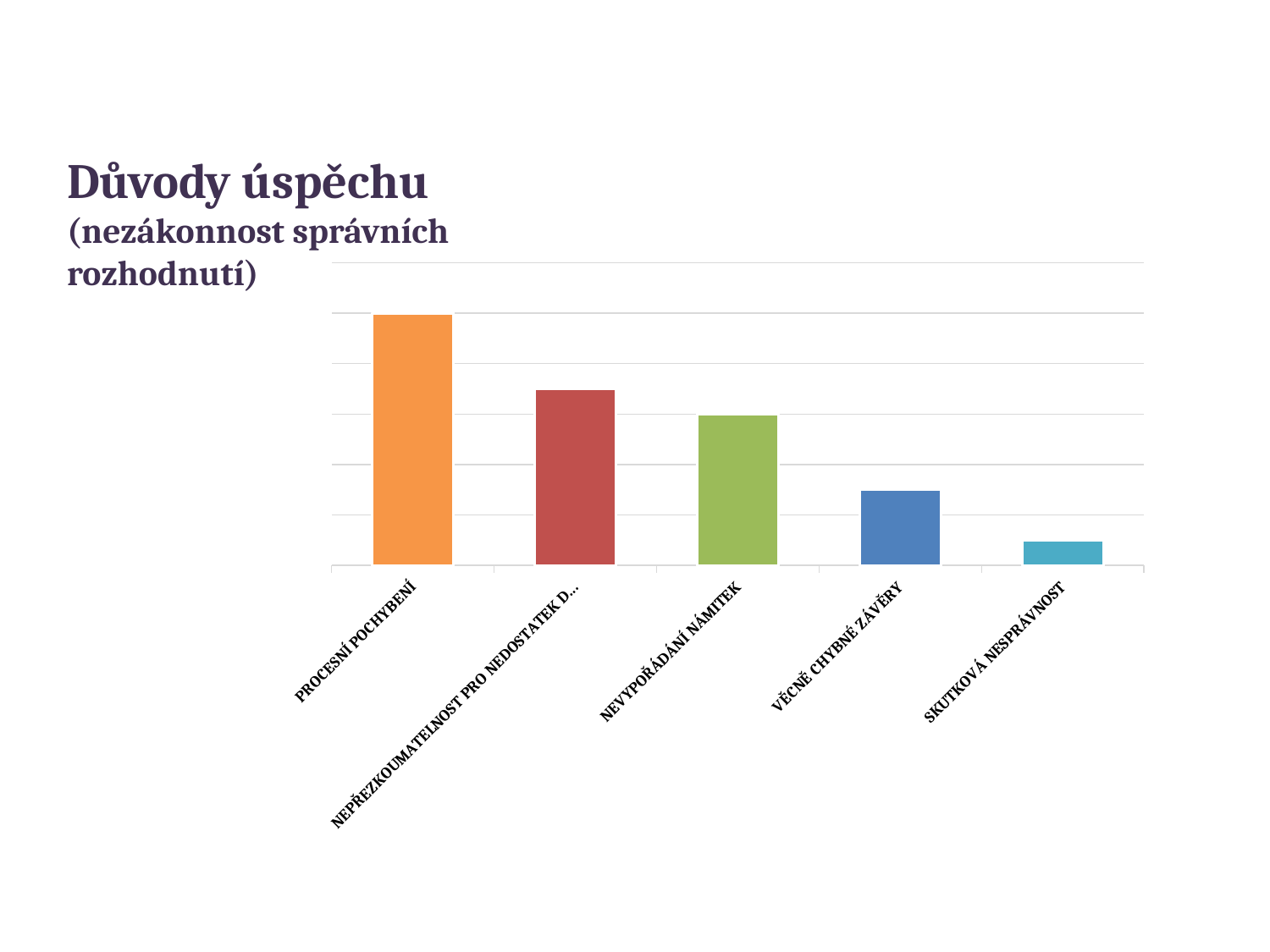
Which is larger, the bar for PROCESNÍ POCHYBENÍ or the bar for NEVYPOŘÁDÁNÍ NÁMITEK? PROCESNÍ POCHYBENÍ What colour is the bar for PROCESNÍ POCHYBENÍ? Orange What kind of chart is shown on the slide? Bar chart Which category has the highest bar? PROCESNÍ POCHYBENÍ Which is larger, the bar for NEVYPOŘÁDÁNÍ NÁMITEK or the bar for VĚCNĚ CHYBNÉ ZÁVĚRY? NEVYPOŘÁDÁNÍ NÁMITEK Which is larger, the bar for SKUTKOVÁ NESPRÁVNOST or the bar for VĚCNĚ CHYBNÉ ZÁVĚRY? VĚCNĚ CHYBNÉ ZÁVĚRY Which category is shown second from the left? NEPŘEZKOUMATELNOST PRO NEDOSTATEK D... Do the bar values rise or fall from left to right along the x axis? Fall How many categories (bars) does the chart show? 5 Which category has the lowest bar? SKUTKOVÁ NESPRÁVNOST